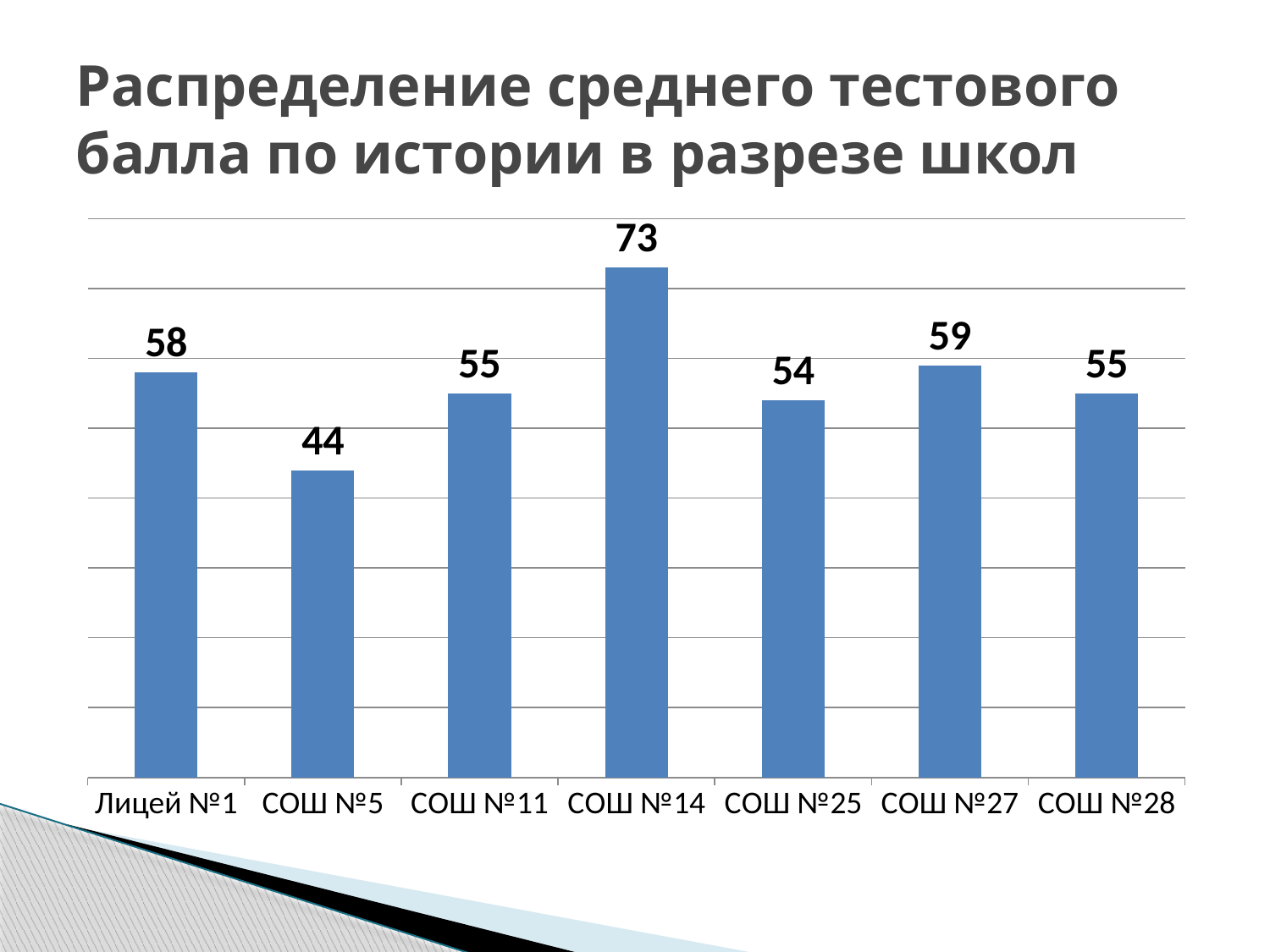
What is the average history test score for Лицей №1? 58 Which has a higher average score, СОШ №27 or СОШ №11? СОШ №27 What is the title of the chart on the slide? Распределение среднего тестового балла по истории в разрезе школ How many schools are shown on the chart? 7 Which school has the highest average history test score? СОШ №14 Which two schools share the same average score of 55? СОШ №11 and СОШ №28 What is the difference between the average scores of СОШ №14 and СОШ №5? 29 What is the average history test score for СОШ №27? 59 What is the difference between the average scores of Лицей №1 and СОШ №25? 4 What kind of chart is shown on the slide? Bar chart What is the average history test score for СОШ №14? 73 Which school has the lowest average history test score? СОШ №5